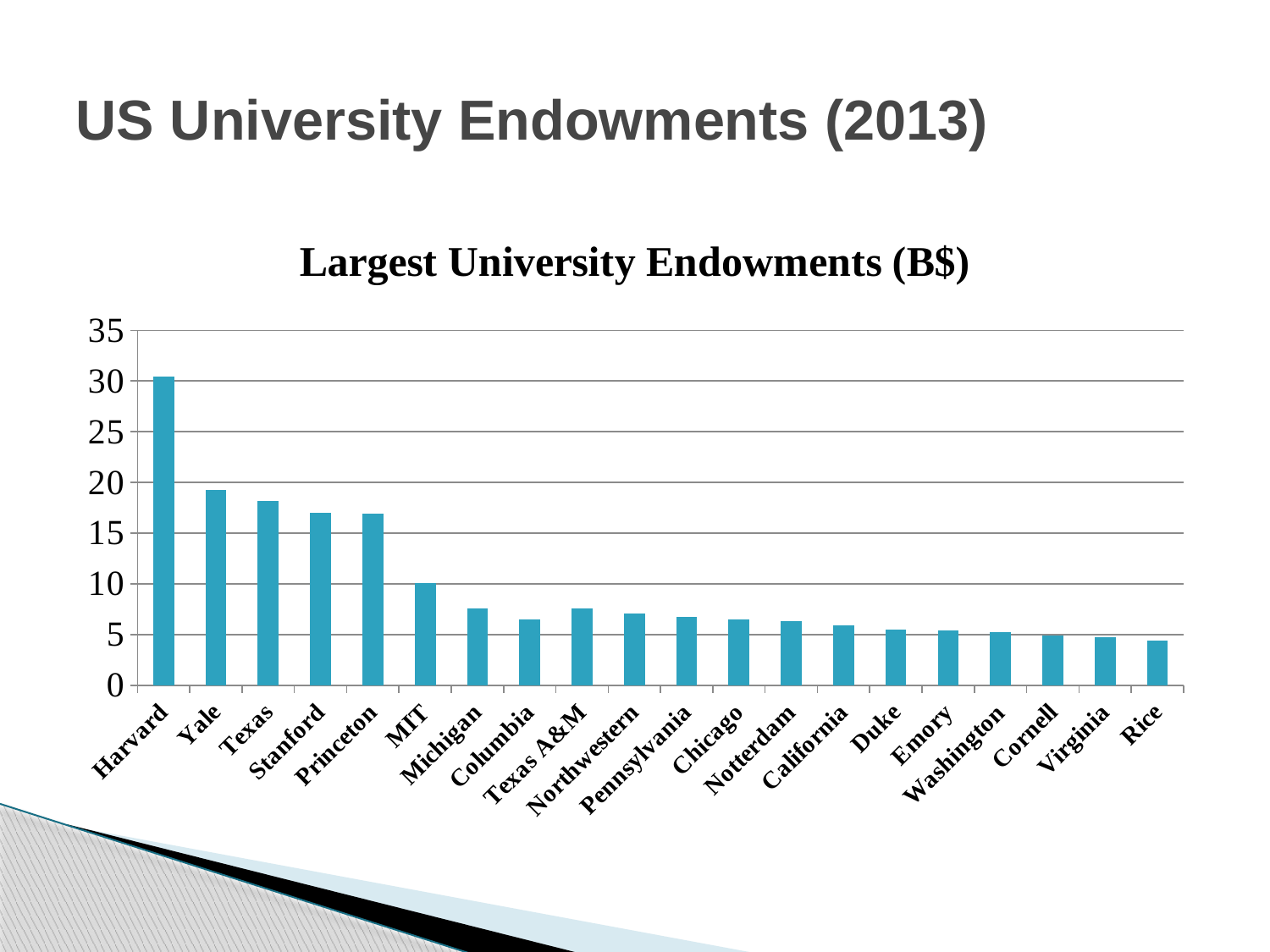
What kind of chart is shown on the slide? Bar chart Which university has the smallest endowment in the chart? Rice What is the title of the chart? Largest University Endowments (B$) Which university has the largest endowment in the chart? Harvard Do the values generally rise or fall moving from left to right along the x axis? Fall How many universities are shown on the x axis of the chart? 20 Is the value for Rice greater or less than 5? less Which has a larger endowment, Yale or Texas? Yale Is the value for Texas greater or less than 15? greater Is the value for Yale greater or less than 20? less Which has a larger endowment, MIT or Michigan? MIT